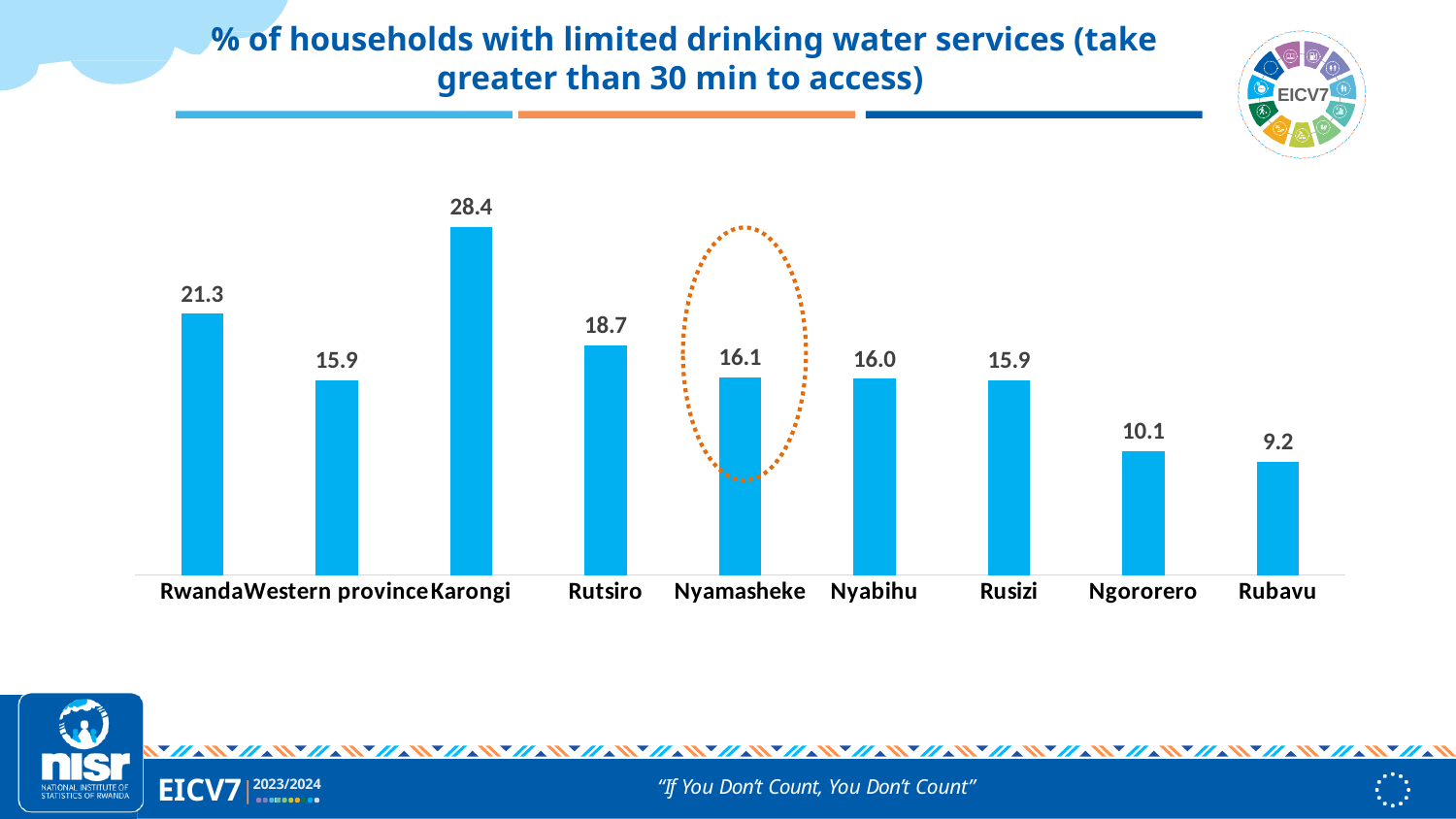
What is the value for Nyamasheke? 16.1 What is the value for Rwanda? 21.3 Which category is highlighted with a dotted orange circle? Nyamasheke What kind of chart is shown on the slide? Bar chart What is the value for Rubavu? 9.2 How many categories are shown on the x axis? 9 What is the difference between the values for Rwanda and Western province? 5.4 What is the value for Karongi? 28.4 Which category has the lowest value? Rubavu What is the difference between the values for Karongi and Rutsiro? 9.7 Which category has the highest value? Karongi Which is larger, the value for Ngororero or the value for Rubavu? Ngororero